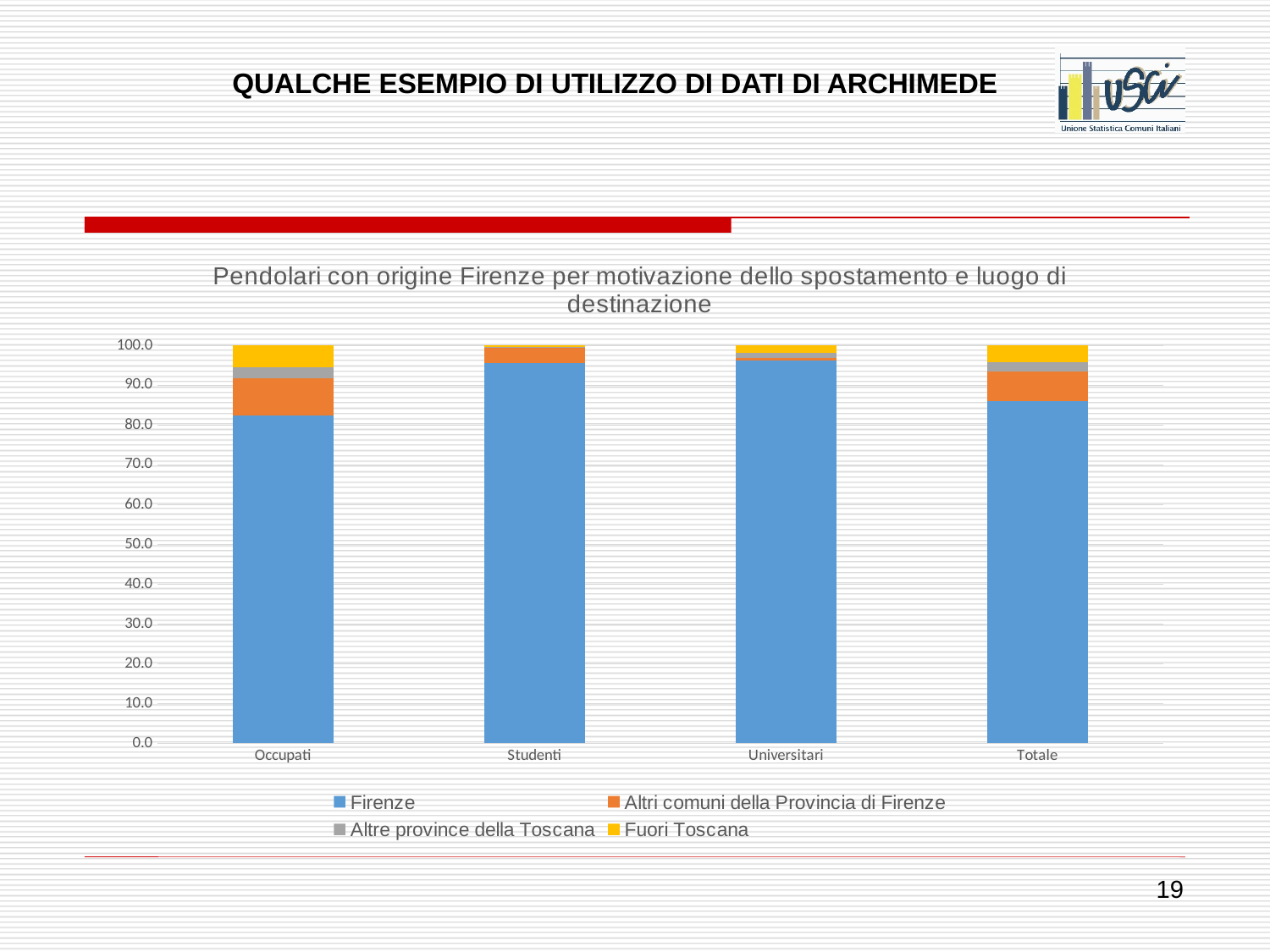
How many series does the chart's legend list? 4 Is the Firenze value for Occupati greater or less than 90? less Is the Firenze value for Totale greater or less than 90? less How many categories are shown on the x axis of the chart? 4 What is the title of the chart? Pendolari con origine Firenze per motivazione dello spostamento e luogo di destinazione Which series is shown in blue in the chart? Firenze Which category has the lowest Firenze value? Occupati Is the Firenze value for Universitari greater or less than 90? greater Which is larger, the Firenze value for Occupati or for Studenti? Studenti What is the total height of the stacked bar for Occupati? 100.0 What kind of chart is shown on the slide? Stacked bar chart